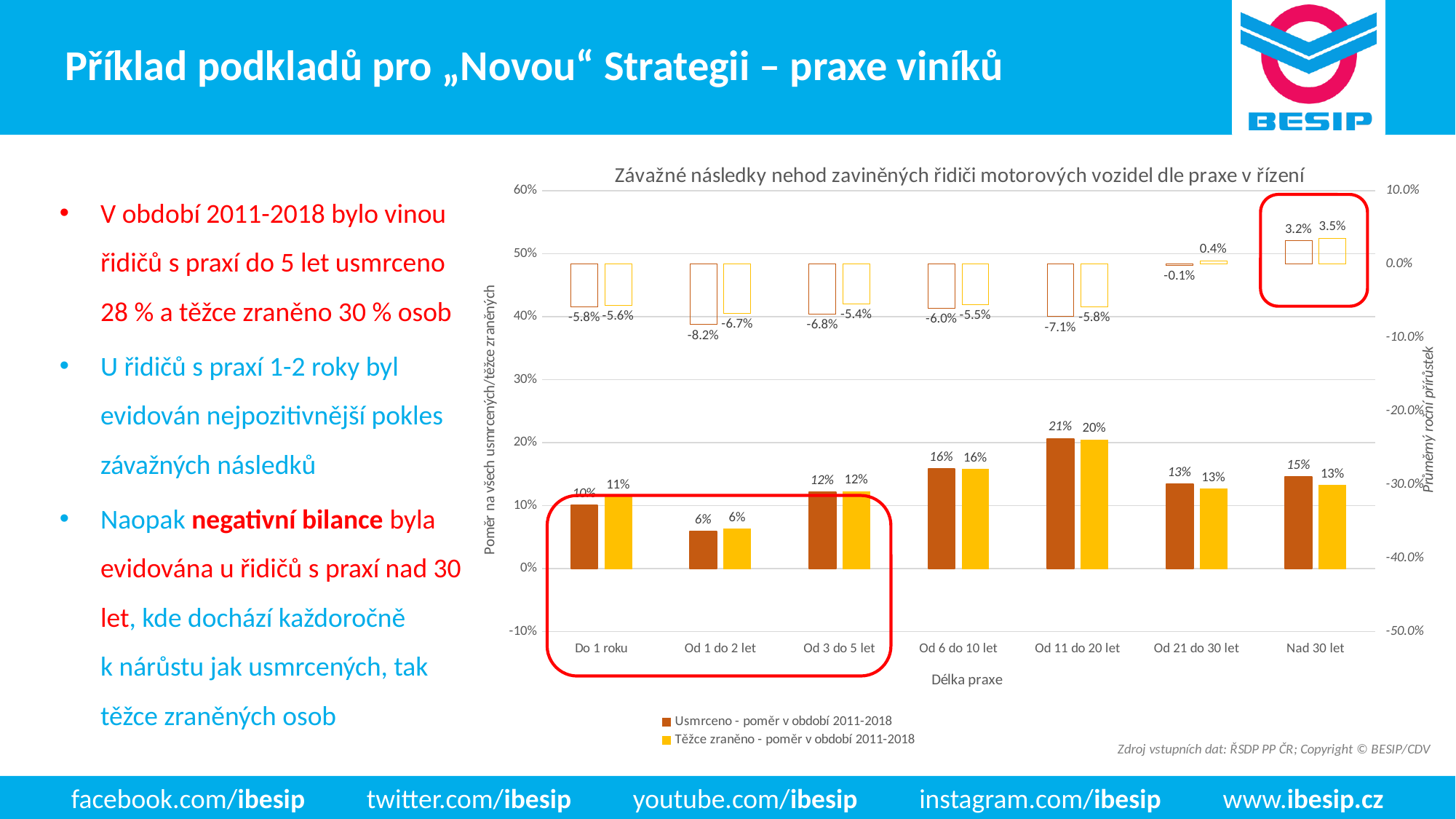
How many series does the legend list? 2 What is the Těžce zraněno share for the Do 1 roku category? 11% What is the average annual change (outlined bar) for Usmrceno in the Od 1 do 2 let category? -8.2% Which category has the lowest Těžce zraněno share? Od 1 do 2 let What is the average annual change (outlined bar) for Těžce zraněno in the Nad 30 let category? 3.5% What kind of chart is shown on the slide? Bar chart Which is larger in the Nad 30 let category: the Usmrceno share or the Těžce zraněno share? Usmrceno What is the Usmrceno share for the Od 11 do 20 let category? 21% What is the title of the chart? Závažné následky nehod zaviněných řidiči motorových vozidel dle praxe v řízení How many categories of driving experience (Délka praxe) are shown on the x axis? 7 Which category has the highest Usmrceno share? Od 11 do 20 let What is the difference between the Usmrceno share for Od 11 do 20 let and for Od 1 do 2 let? 15%